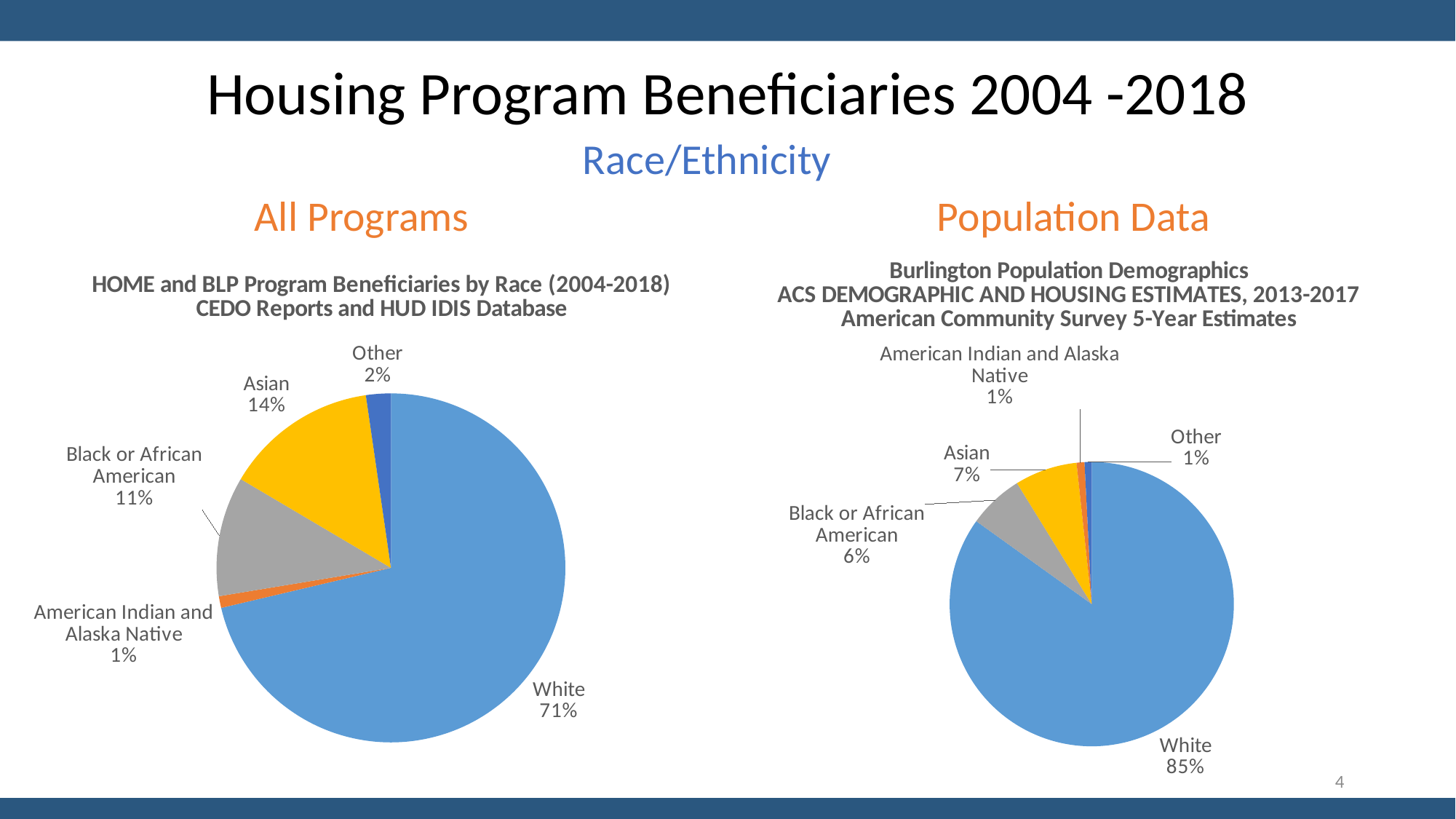
What is the title of the left chart? HOME and BLP Program Beneficiaries by Race (2004-2018) CEDO Reports and HUD IDIS Database In the right pie chart (Population Data), what share of the population is Black or African American? 6% In the left pie chart (All Programs), which category has the largest slice? White Is the Asian share larger in the All Programs chart or in the Population Data chart? All Programs In the left pie chart (All Programs), what is the difference between the Asian share and the Black or African American share? 3 percentage points What type of chart is used on the right (Population Data)? Pie chart In the right pie chart (Population Data), what share of the population is White? 85% What is the difference between the White share in the Population Data chart and the White share in the All Programs chart? 14 percentage points How many categories are shown in the left pie chart (All Programs)? 5 In the left pie chart (All Programs), what share of beneficiaries is White? 71% In the right pie chart (Population Data), which category has the smallest share, Asian or Black or African American? Black or African American In the left pie chart (All Programs), what share of beneficiaries is Asian? 14%